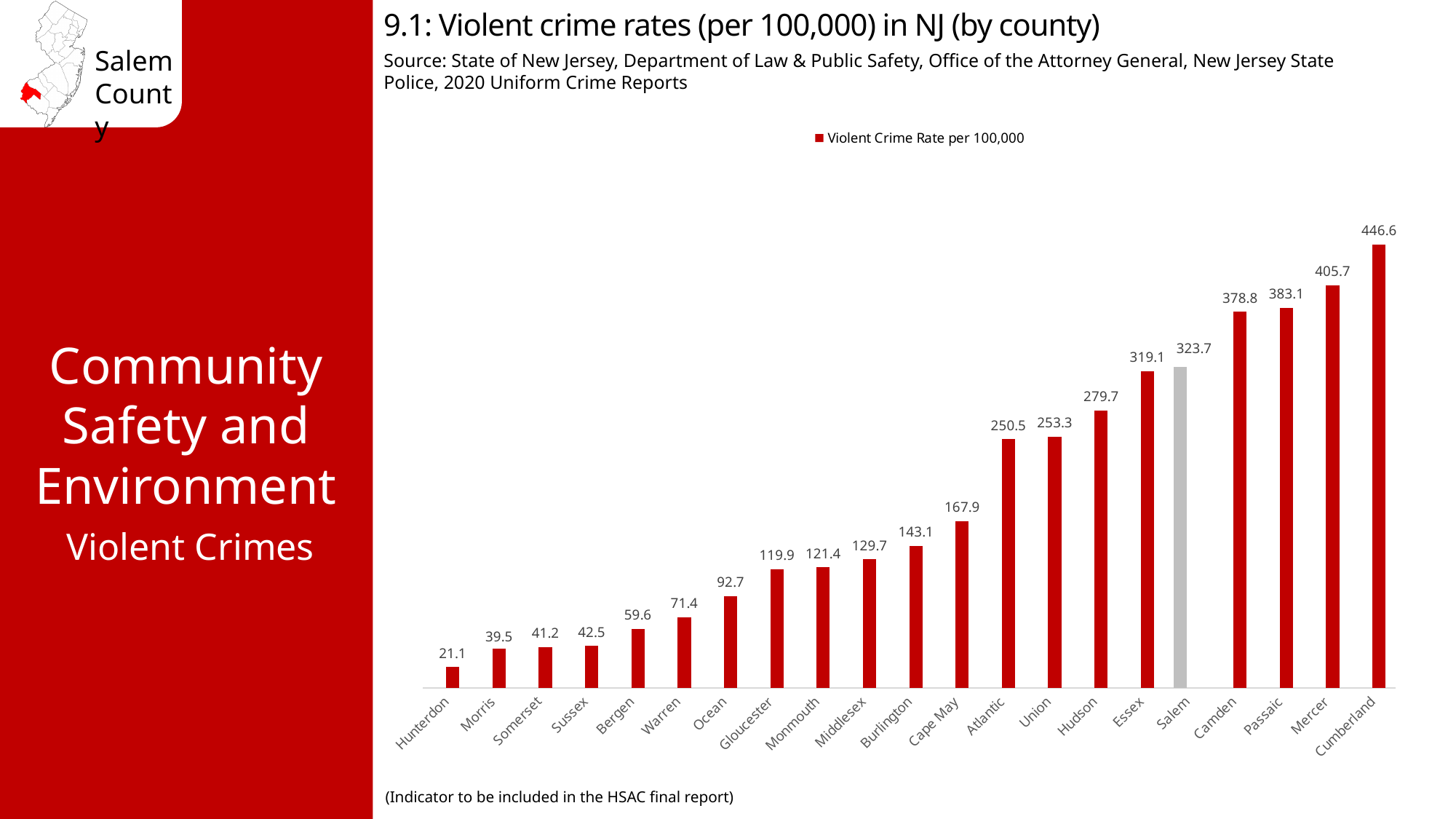
Which county has the highest violent crime rate? Cumberland What is the violent crime rate per 100,000 for Hudson county? 279.7 How many counties are shown on the chart? 21 Which county's bar is shown in grey rather than red? Salem What is the difference between the violent crime rates of Cumberland and Salem? 122.9 What is the difference between the violent crime rates of Salem and Hunterdon? 302.6 What kind of chart is shown on the slide? Bar chart What is the violent crime rate per 100,000 for Salem county? 323.7 What is the violent crime rate per 100,000 for Gloucester county? 119.9 Which county has a higher violent crime rate, Essex or Camden? Camden How many series does the legend list? 1 Which county has the lowest violent crime rate? Hunterdon